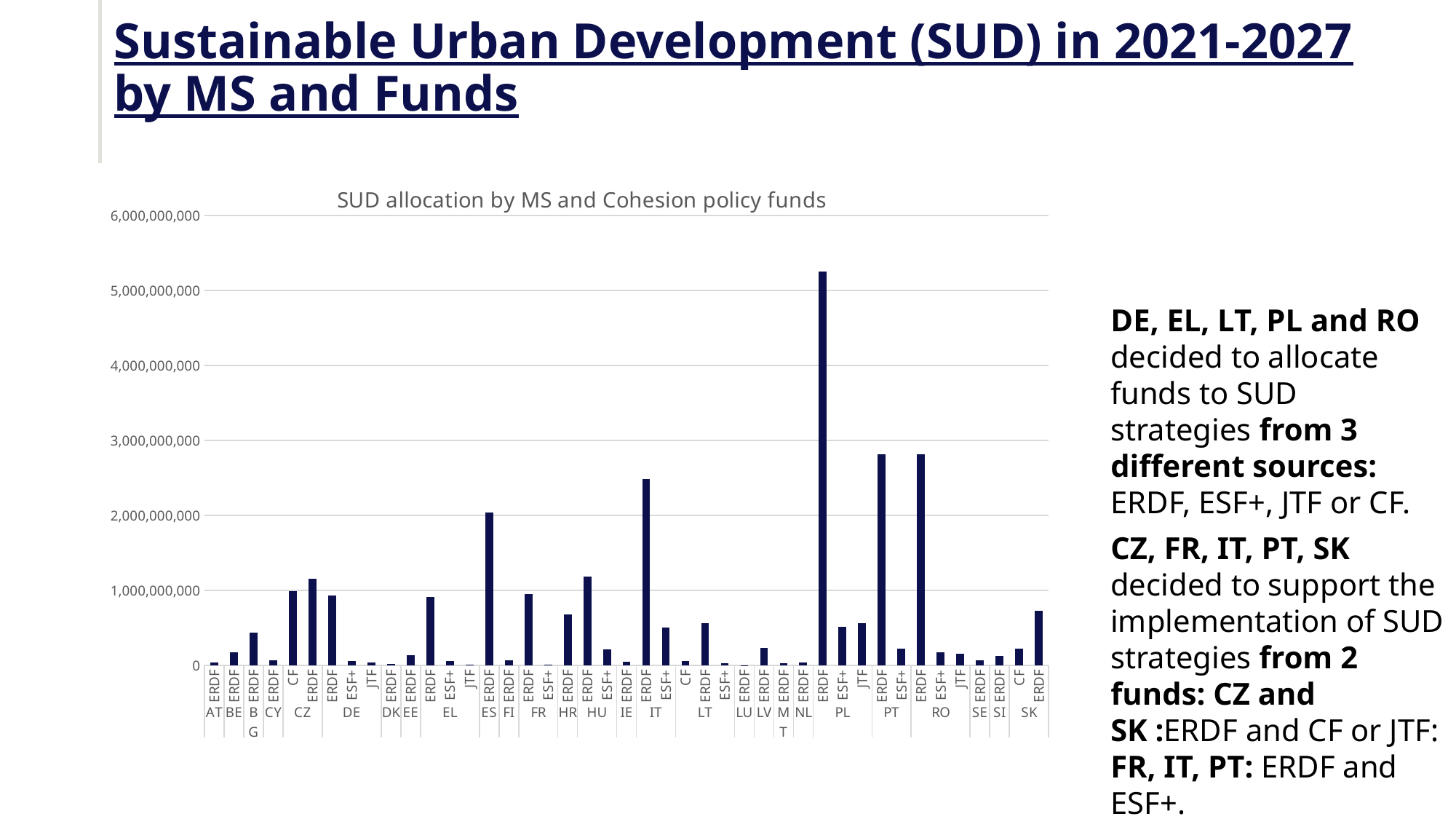
Which member state and fund has the highest SUD allocation in the chart? PL ERDF Which is larger, the SUD allocation for HU ERDF or for HU ESF+? HU ERDF What is the title of the chart? SUD allocation by MS and Cohesion policy funds Which is larger, the SUD allocation for PL ERDF or for RO ERDF? PL ERDF Is the value for SK ERDF greater or less than 1,000,000,000? less Is the value for PT ERDF greater or less than 3,000,000,000? less Is the value for PL ERDF greater or less than 5,000,000,000? greater Which is larger, the SUD allocation for PT ERDF or for IT ERDF? PT ERDF What kind of chart is shown on the slide? bar chart How many member states are shown on the x axis of the chart? 27 Which four fund types appear as labels on the x axis of the chart? ERDF, ESF+, JTF and CF